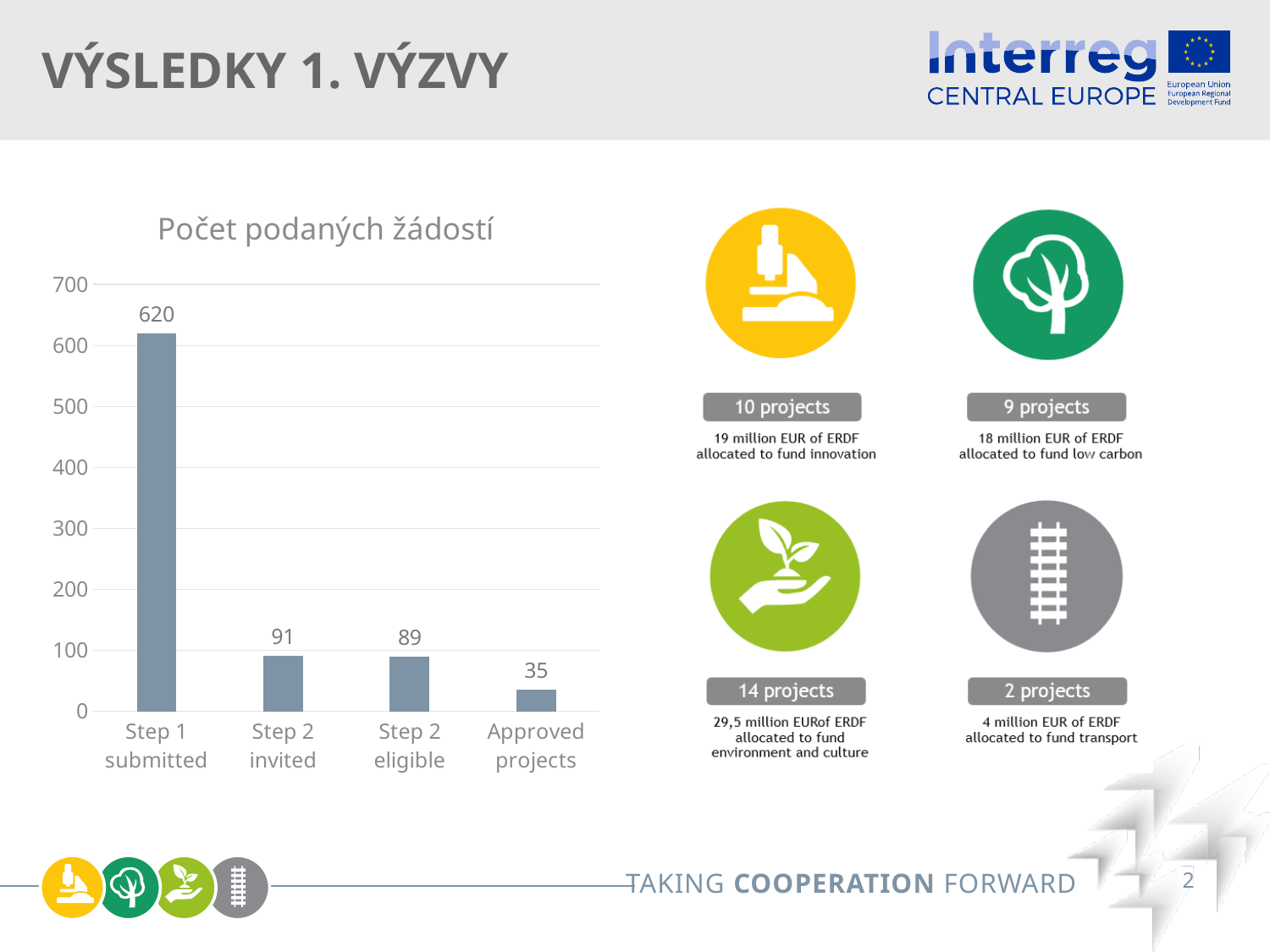
Which category has the highest value? Step 1 submitted What is the difference between Step 1 submitted and Approved projects? 585 What is the title of the chart? Počet podaných žádostí What is the difference between Step 2 invited and Step 2 eligible? 2 How many categories are shown on the x axis? 4 What is the value for Step 2 eligible? 89 What is the value for Step 1 submitted? 620 What is the value for Approved projects? 35 Which is larger, Step 2 invited or Approved projects? Step 2 invited What is the value for Step 2 invited? 91 What kind of chart is shown? Bar chart Which category has the lowest value? Approved projects